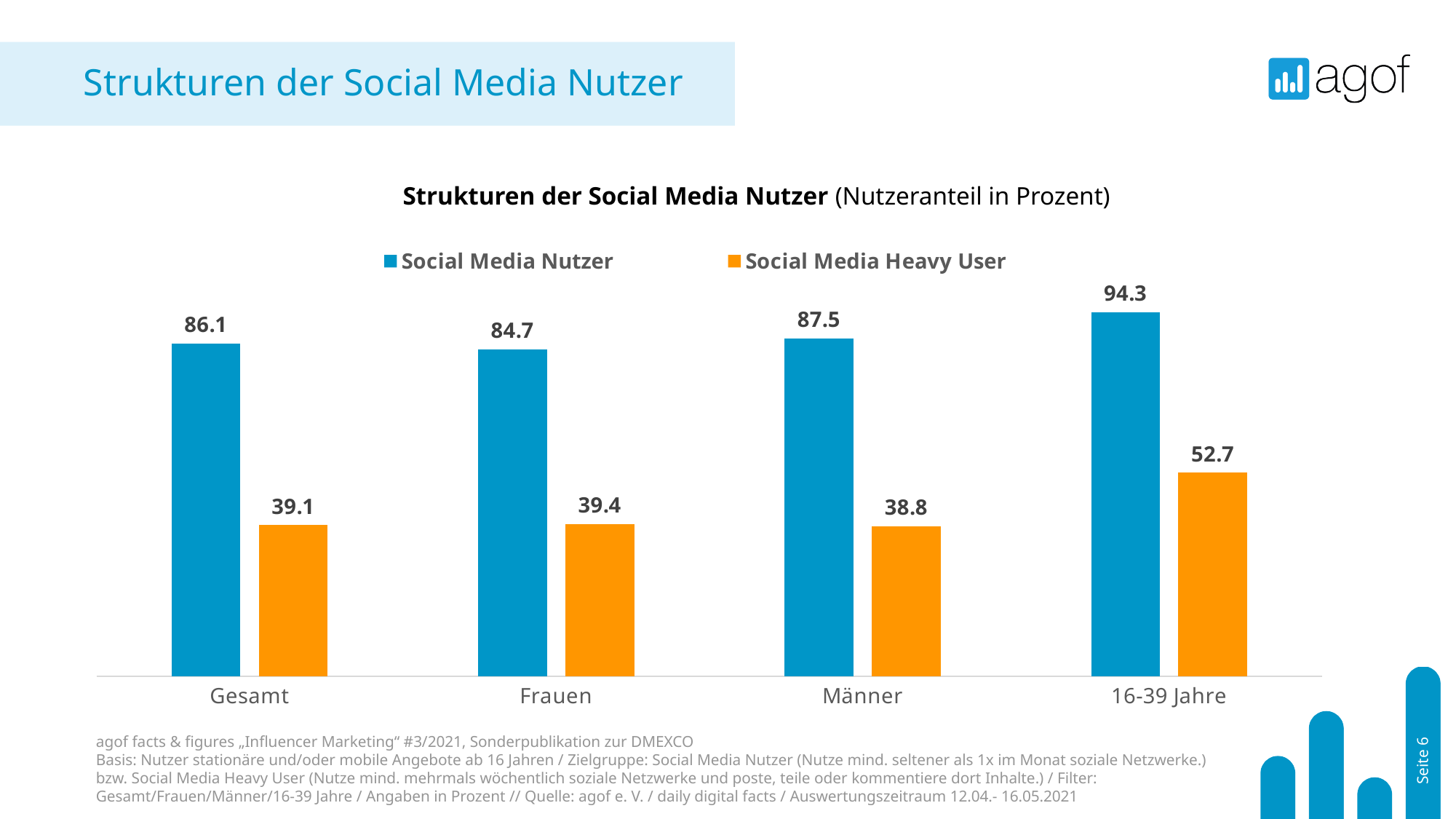
Which category has the highest value for Social Media Nutzer? 16-39 Jahre What is the value for Social Media Nutzer in the Gesamt category? 86.1 What is the value for Social Media Heavy User in the 16-39 Jahre category? 52.7 Which is larger: the Social Media Nutzer value for Männer or for Frauen? Männer How many series does the legend list? 2 What is the difference between the Social Media Nutzer values for 16-39 Jahre and Frauen? 9.6 What is the value for Social Media Heavy User in the Männer category? 38.8 Which category has the lowest value for Social Media Heavy User? Männer How many categories are shown on the x axis? 4 What kind of chart is shown on the slide? Bar chart What is the difference between the Social Media Nutzer and Social Media Heavy User values for Gesamt? 47.0 Which category has the lowest value for Social Media Nutzer? Frauen